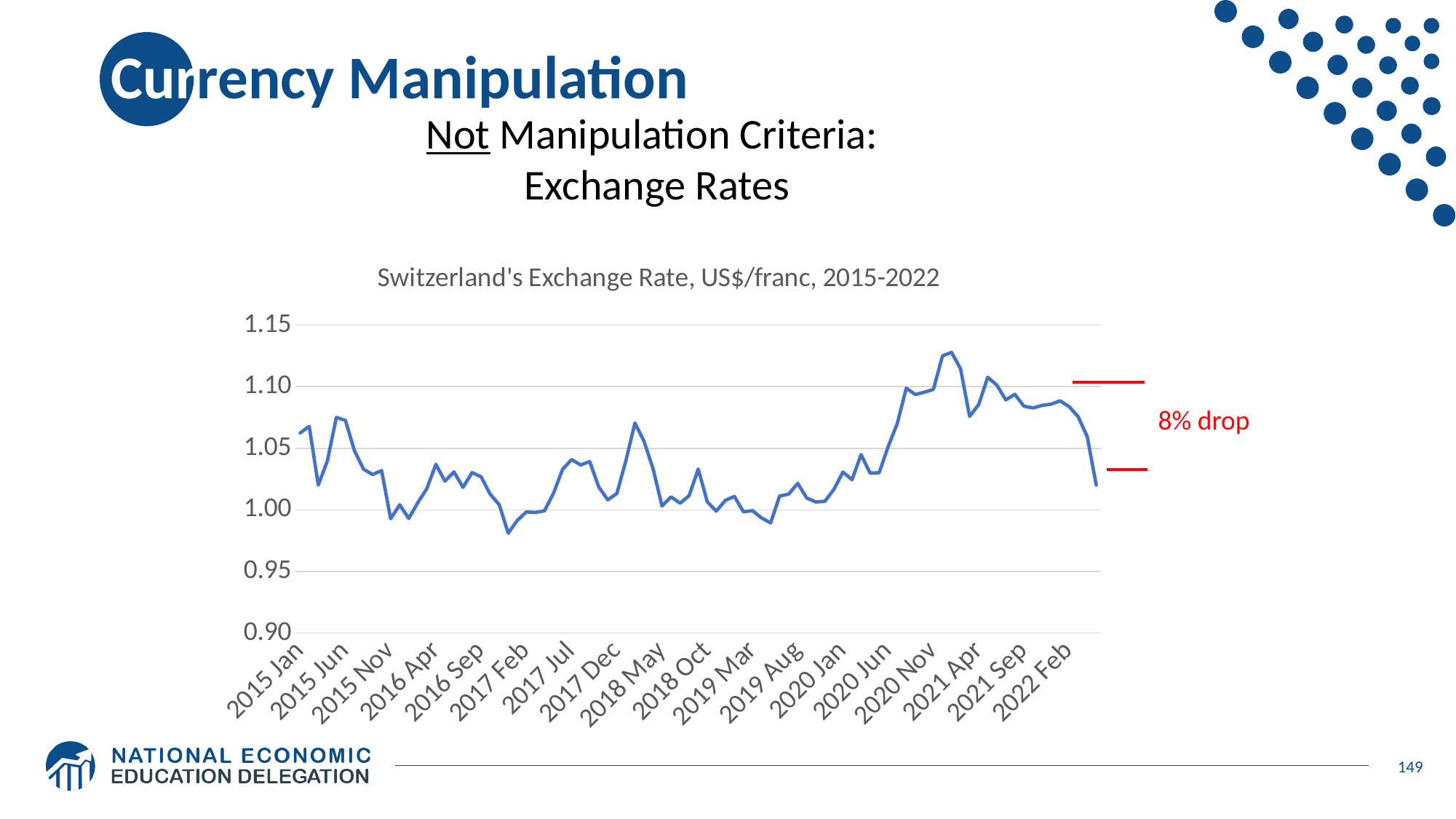
Does the exchange rate rise or fall between 2020 Jan and 2020 Nov? Rise Which is larger, the value for 2020 Nov or the value for 2019 Mar? 2020 Nov How many date labels are shown on the x axis? 18 What kind of chart is shown on the slide? Line chart Which is larger, the value for 2015 Jun or the value for 2017 Feb? 2015 Jun Is the value for 2019 Mar greater or less than 1.05? less Is the value for 2015 Jan greater or less than 1.05? greater Is the highest point on the line greater or less than 1.10? greater What does the red annotation to the right of the chart say? 8% drop What is the title of the chart? Switzerland's Exchange Rate, US$/franc, 2015-2022